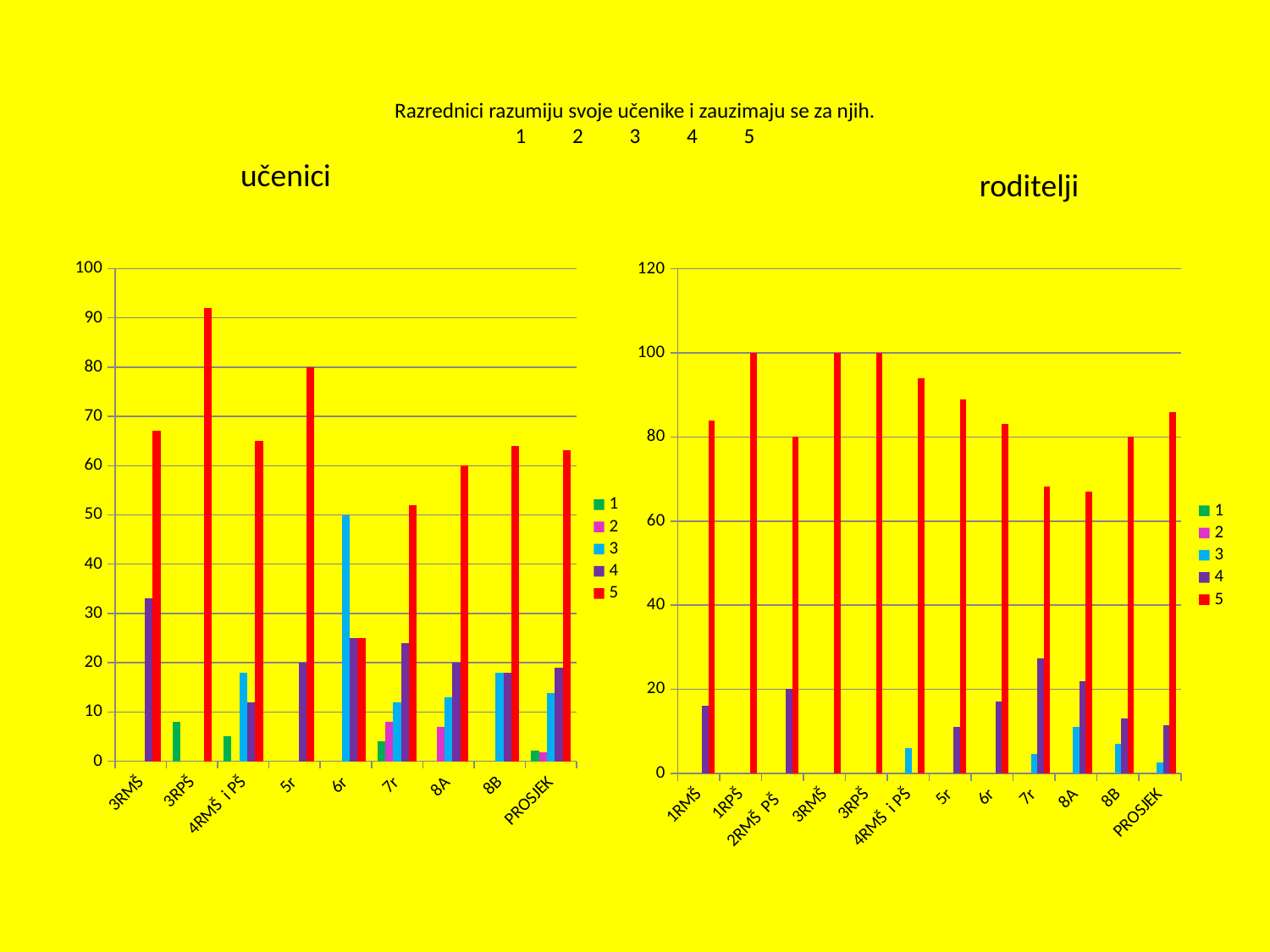
In the 'roditelji' chart, which is larger for series 5: 1RMŠ or 1RPŠ? 1RPŠ What kind of chart is the 'učenici' chart on the left? bar chart How many categories are shown on the x axis of the 'roditelji' chart? 12 In the 'učenici' chart, which category has the highest value for series 5? 3RPŠ How many series does the legend of the 'roditelji' chart list? 5 In the 'roditelji' chart, is the value of series 5 for 5r greater or less than 80? greater In the 'učenici' chart, what is the value of series 3 for 6r? 50 In the 'učenici' chart, which category has the lowest value for series 5? 6r In the 'učenici' chart, what is the value of series 5 for 5r? 80 In the 'roditelji' chart, what is the value of series 5 for 8B? 80 How many categories are shown on the x axis of the 'učenici' chart? 9 What is the highest value shown on the y axis of the 'roditelji' chart? 120